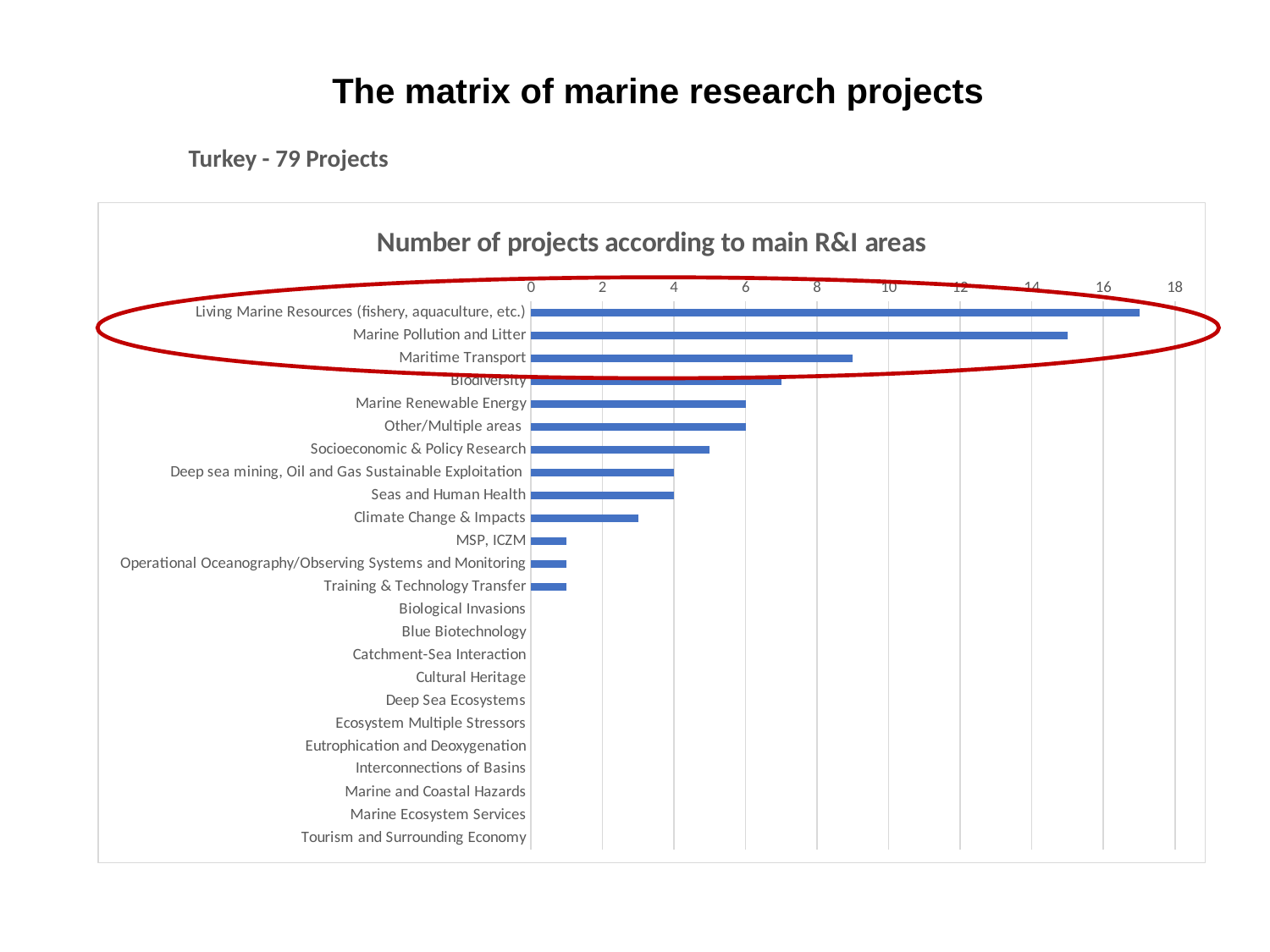
What is the difference between the number of projects for Marine Renewable Energy and for Deep sea mining, Oil and Gas Sustainable Exploitation? 2 What is the title of the chart? Number of projects according to main R&I areas Which R&I area has the highest number of projects? Living Marine Resources (fishery, aquaculture, etc.) What is the number of projects for Marine Renewable Energy? 6 How many of the listed R&I areas show no bar at all (zero projects)? 11 Is the value for Living Marine Resources (fishery, aquaculture, etc.) greater or less than 16? greater What kind of chart is shown on the slide? bar chart What is the number of projects for Seas and Human Health? 4 How many R&I area categories are listed on the chart's axis? 24 Which has more projects, Climate Change & Impacts or Socioeconomic & Policy Research? Socioeconomic & Policy Research Is the value for Maritime Transport greater or less than 10? less Which has more projects, Maritime Transport or Biodiversity? Maritime Transport